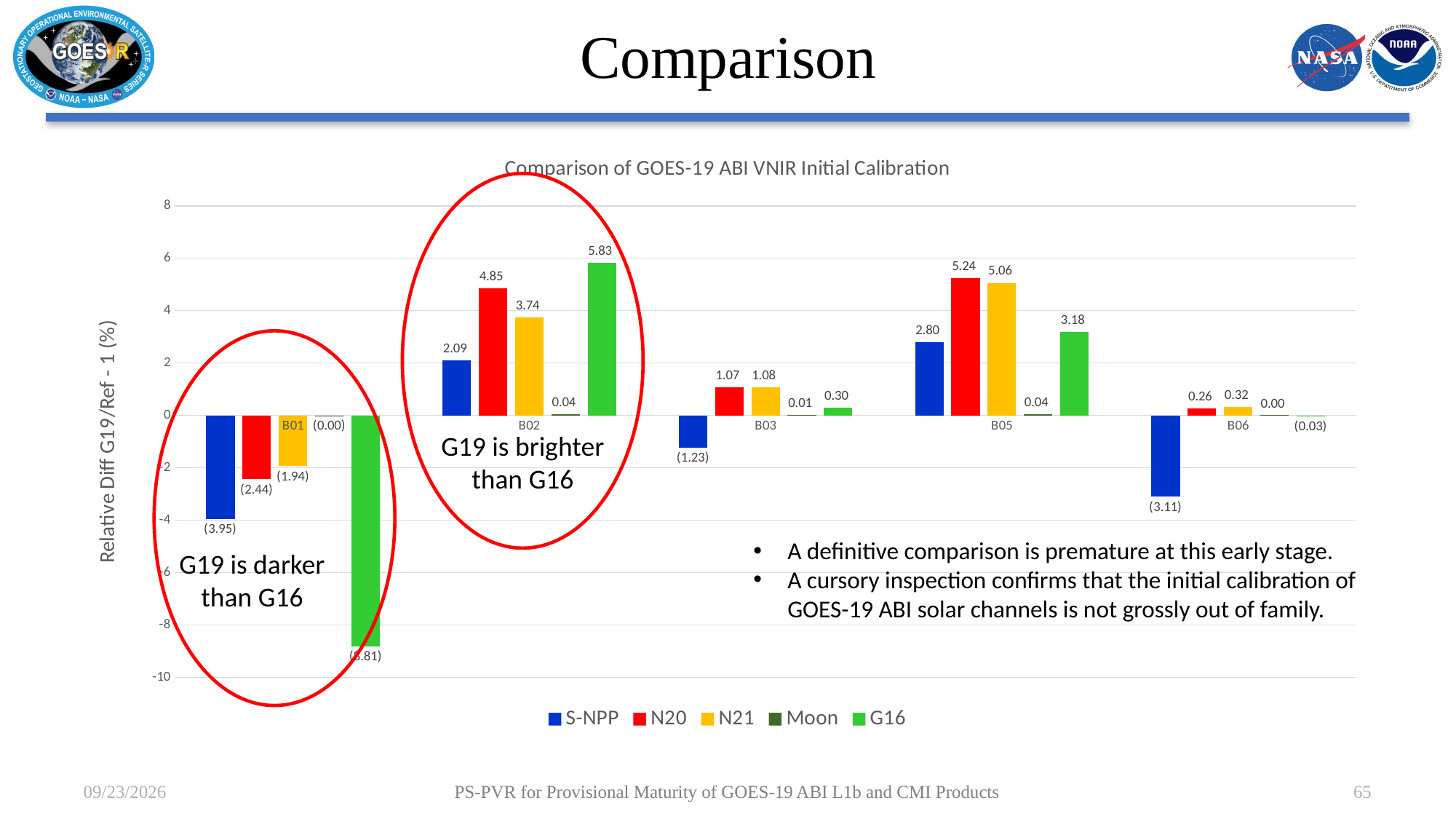
At B02, which is larger: the N20 value or the N21 value? N20 At B05, what is the difference between the N20 value and the N21 value? 0.18 For which band is the G16 value highest? B02 How many bands (categories) are shown on the x axis? 5 What is the value for S-NPP at B06? (3.11) What is the value for G16 at B02? 5.83 What type of chart is shown on the slide? bar chart What is the value for N20 at B05? 5.24 For which band is the S-NPP value lowest? B01 Is the value for G16 at B01 greater or less than -8? less What is the value for Moon at B03? 0.01 How many series does the legend list? 5